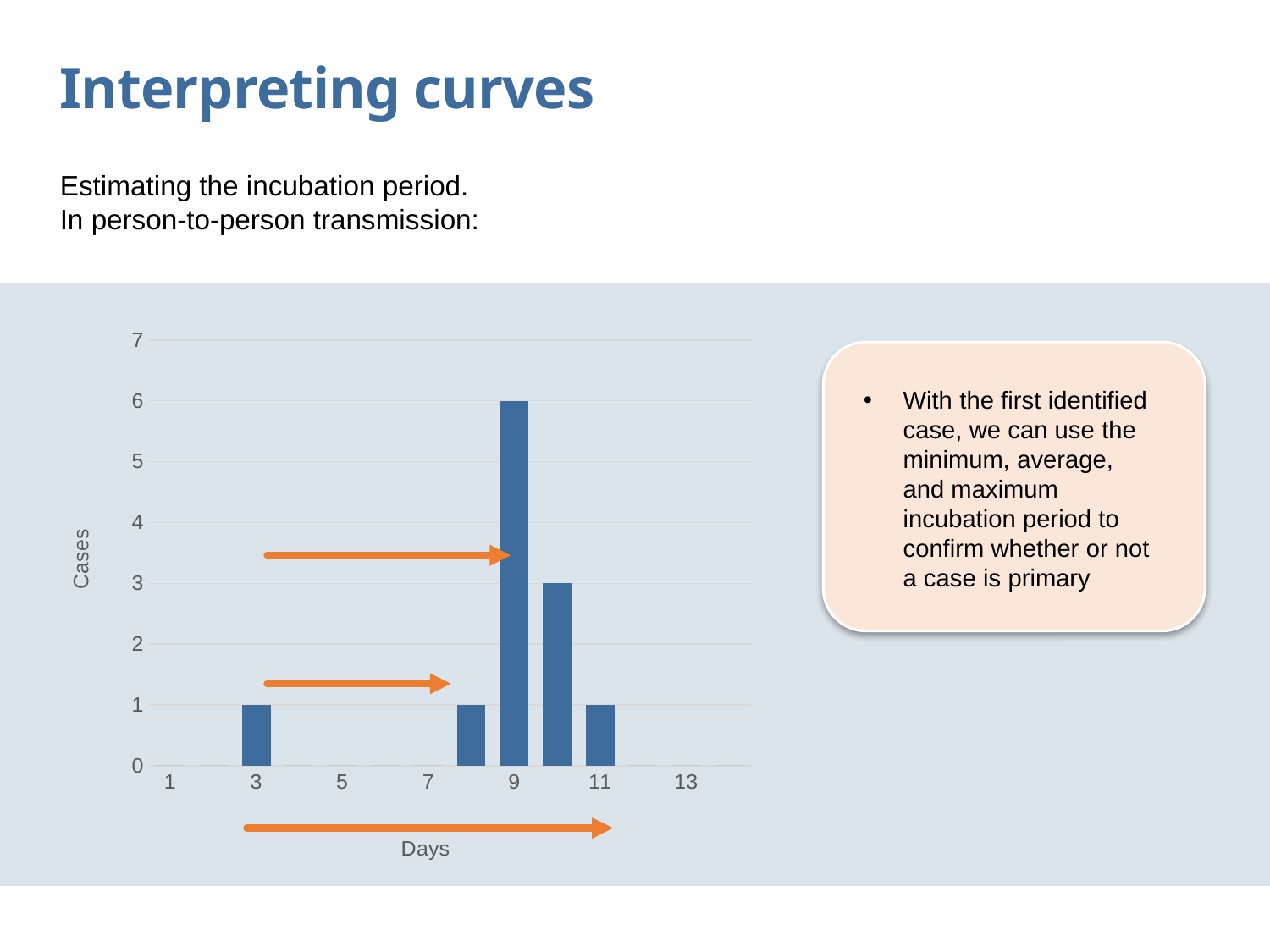
What type of chart is shown on the slide? bar chart What is the label of the x axis? Days How many cases are shown on day 9? 6 Which day has more cases, day 9 or day 11? 9 Is the number of cases on day 9 greater or less than 5? greater On which day is the number of cases highest? 9 How many cases are shown on day 11? 1 What is the highest value shown on the y axis? 7 What is the label of the y axis? Cases How many cases are shown on day 3? 1 How many bars are plotted in the chart? 5 What is the difference in cases between day 9 and day 3? 5